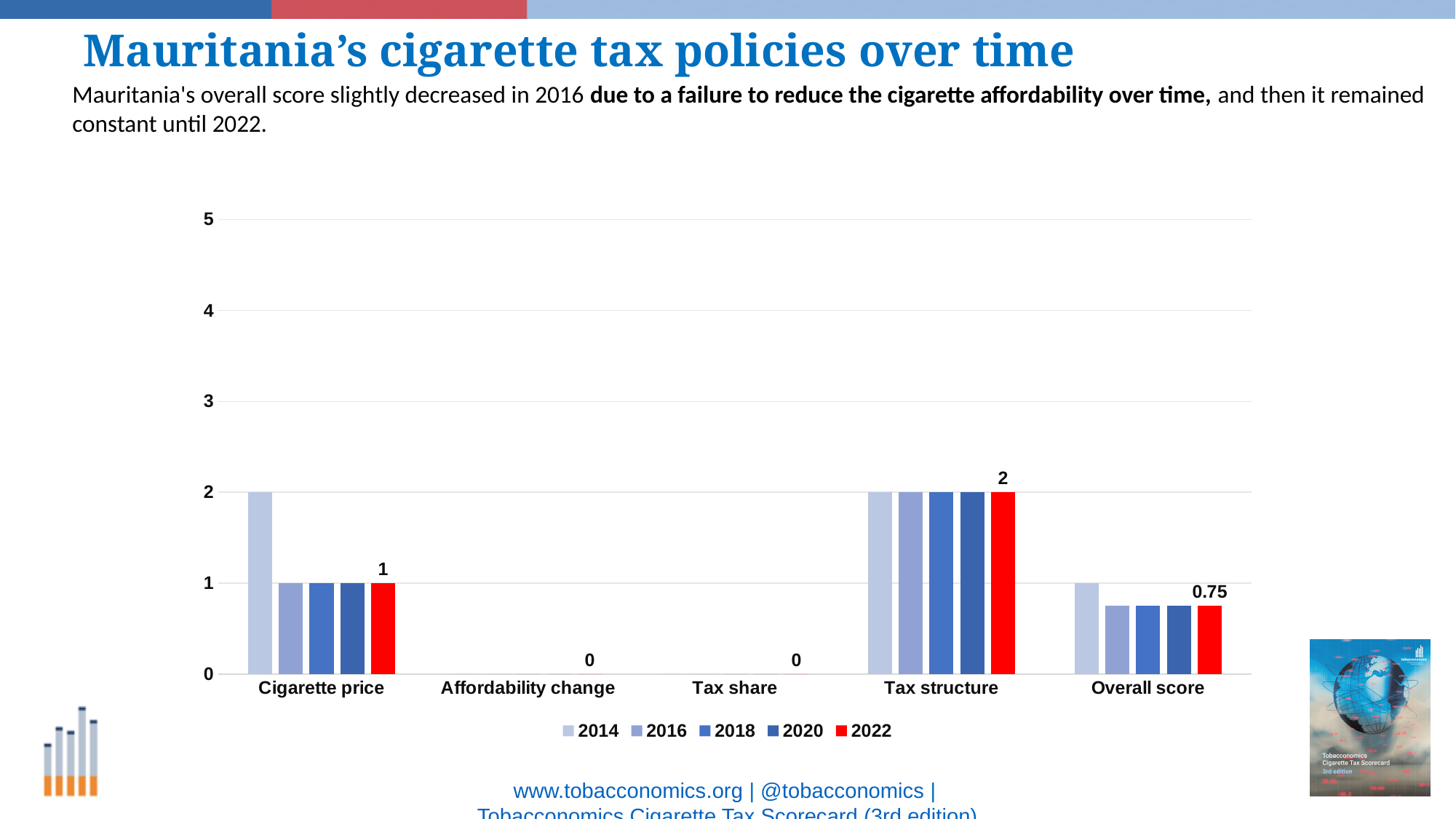
How many series does the legend list? 5 What is the value for 2022 in the Cigarette price category? 1 What kind of chart is shown on the slide? bar chart Which is larger for 2022: Cigarette price or Tax structure? Tax structure What is the value for 2022 in the Affordability change category? 0 What is the difference between the 2022 values for Tax structure and Cigarette price? 1 Is the value for 2014 in the Cigarette price category greater or less than 1? greater What is the value for 2022 in the Tax structure category? 2 Which colour represents the 2022 series in the legend? red What is the value for 2022 in the Overall score category? 0.75 Which category has the highest value for 2022? Tax structure How many categories are shown on the x axis? 5